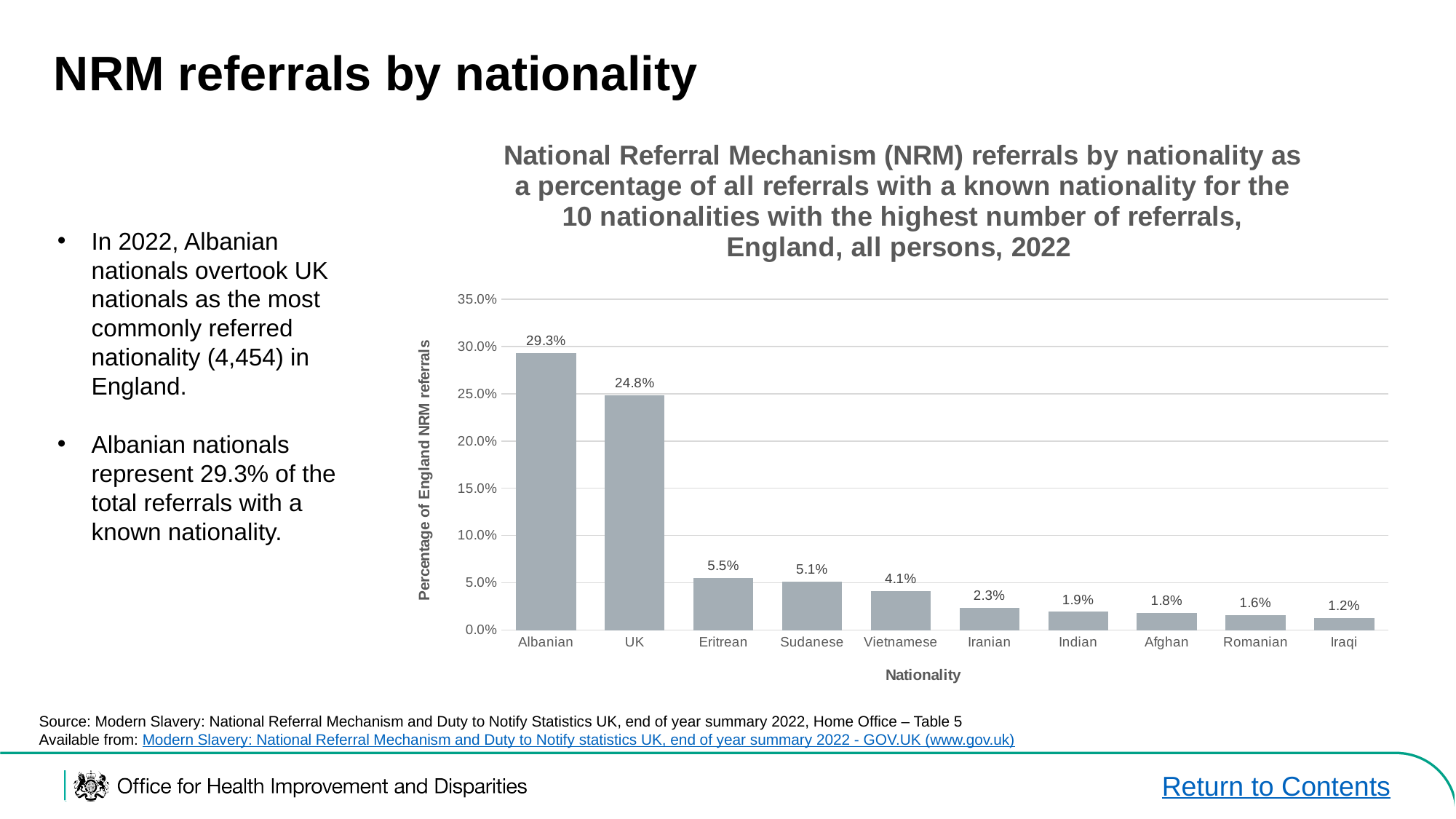
Which is larger, the value for Eritrean or the value for Sudanese? Eritrean Is the value for UK nationals greater or less than 25.0%? less Which nationality has the lowest percentage of NRM referrals? Iraqi What is the value shown for Vietnamese nationals? 4.1% What is the difference in percentage points between Albanian and UK nationals? 4.5 percentage points What percentage of England NRM referrals were Albanian nationals? 29.3% Do the values rise or fall moving from left to right along the x axis? Fall What is the label of the y axis? Percentage of England NRM referrals How many nationalities are shown on the chart? 10 What percentage of England NRM referrals were UK nationals? 24.8% What kind of chart is shown on the slide? Bar chart Which nationality has the highest percentage of NRM referrals? Albanian